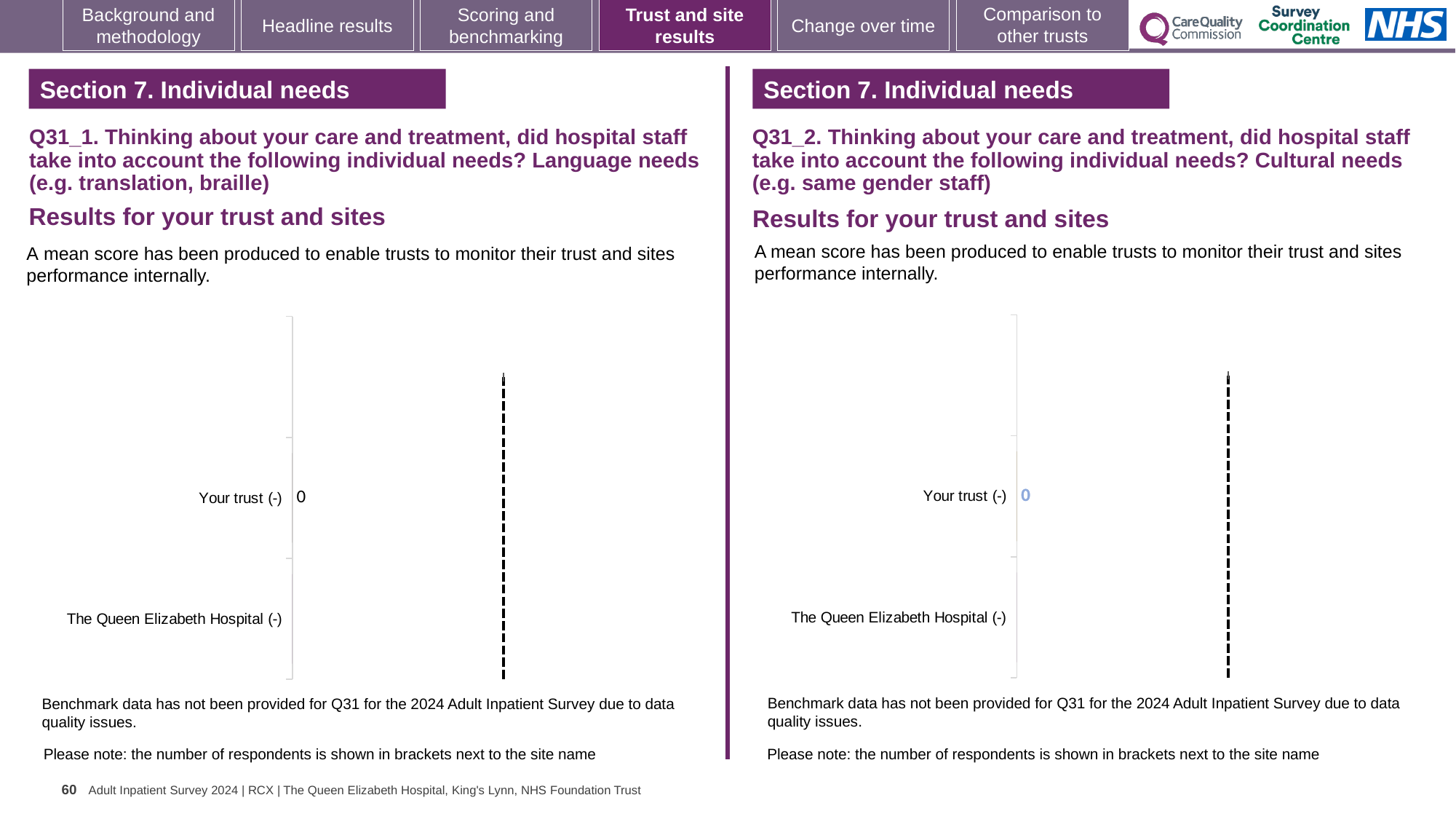
What kind of chart is the left chart (Q31_1, Language needs)? Bar chart On the right chart (Q31_2, Cultural needs), what value is shown for Your trust? 0 What kind of chart is the right chart (Q31_2, Cultural needs)? Bar chart On the right chart (Q31_2, Cultural needs), what is shown in brackets next to Your trust as the number of respondents? - On the left chart (Q31_1, Language needs), what is the name of the site category listed below Your trust? The Queen Elizabeth Hospital (-) How many categories are listed on the right chart (Q31_2, Cultural needs)? 2 On the left chart (Q31_1, Language needs), what value is shown for Your trust? 0 How many categories are listed on the left chart (Q31_1, Language needs)? 2